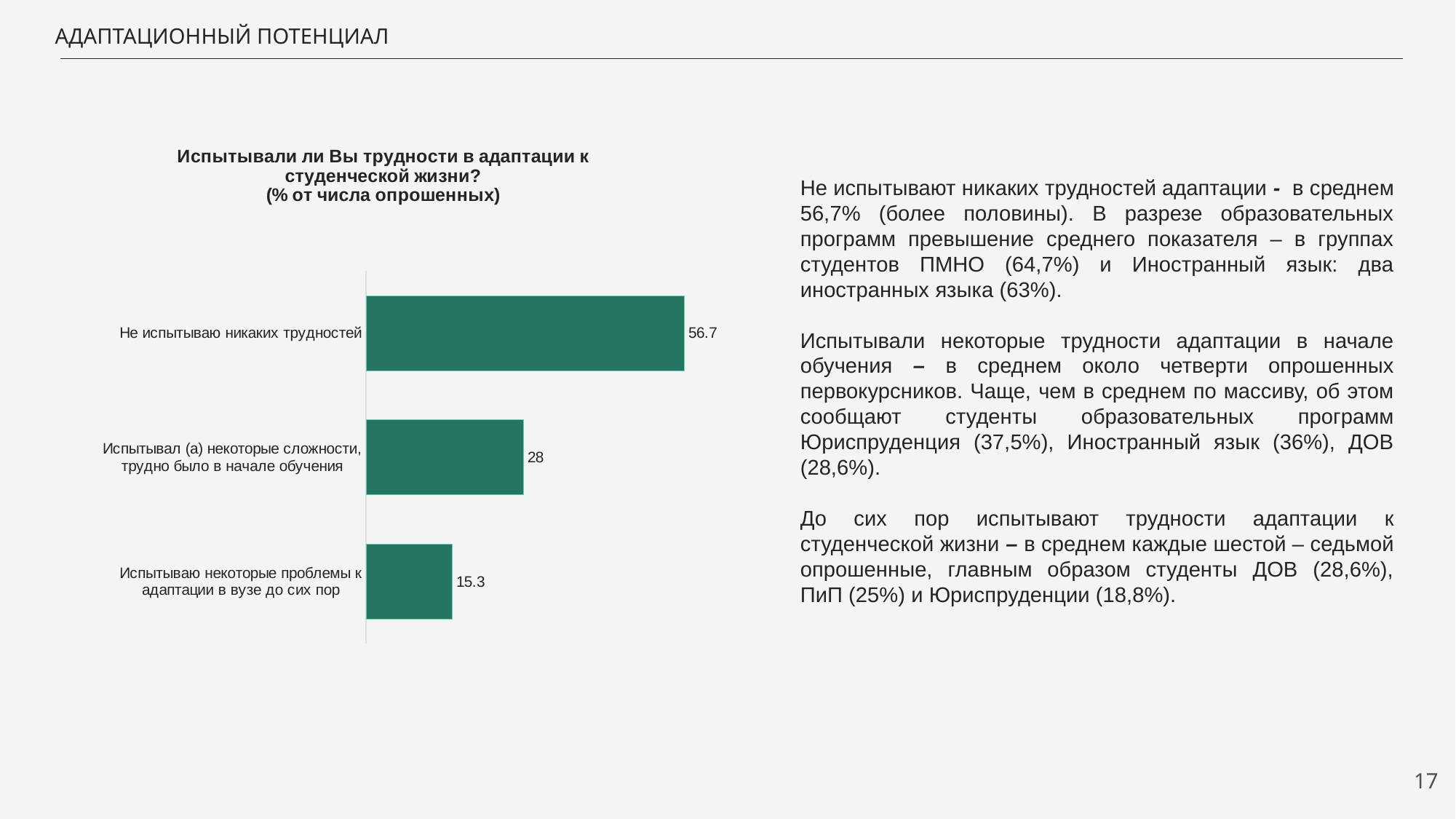
What colour are the bars in the chart? Green What value is shown for "Не испытываю никаких трудностей"? 56.7 Which category has the lowest value? Испытываю некоторые проблемы к адаптации в вузе до сих пор What value is shown for "Испытывал (а) некоторые сложности, трудно было в начале обучения"? 28 Which category has the highest value? Не испытываю никаких трудностей What is the difference between the values for "Не испытываю никаких трудностей" and "Испытывал (а) некоторые сложности, трудно было в начале обучения"? 28.7 What is the difference between the values for "Испытывал (а) некоторые сложности, трудно было в начале обучения" and "Испытываю некоторые проблемы к адаптации в вузе до сих пор"? 12.7 What kind of chart is shown on the slide? Bar chart What value is shown for "Испытываю некоторые проблемы к адаптации в вузе до сих пор"? 15.3 What is the title of the chart? Испытывали ли Вы трудности в адаптации к студенческой жизни? (% от числа опрошенных) How many categories are shown in the chart? 3 Which is larger: the value for "Испытывал (а) некоторые сложности, трудно было в начале обучения" or for "Испытываю некоторые проблемы к адаптации в вузе до сих пор"? Испытывал (а) некоторые сложности, трудно было в начале обучения